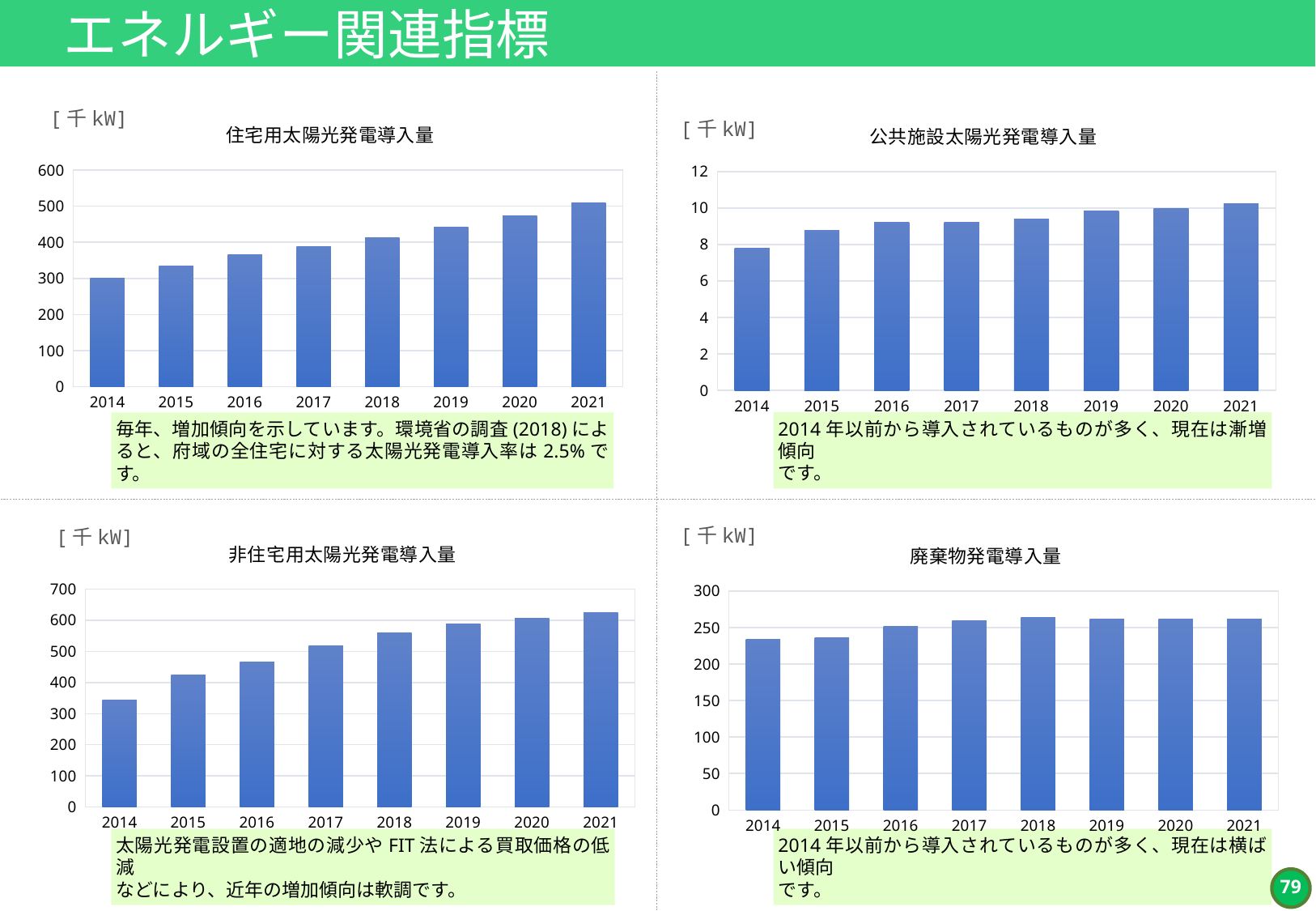
On the 住宅用太陽光発電導入量 chart, which year has the lowest value? 2014 On the 公共施設太陽光発電導入量 chart, is the value for 2015 greater or less than 8? greater On the 公共施設太陽光発電導入量 chart, which year has the lowest value? 2014 On the 住宅用太陽光発電導入量 chart, is the value for 2016 greater or less than 400? less On the 非住宅用太陽光発電導入量 chart, which year has the highest value? 2021 On the 廃棄物発電導入量 chart, which is larger, the value for 2014 or the value for 2021? 2021 On the 住宅用太陽光発電導入量 chart, which year has the highest value? 2021 On the 非住宅用太陽光発電導入量 chart, is the value for 2021 greater or less than 600? greater On the 住宅用太陽光発電導入量 chart, do the values rise or fall from 2014 to 2021? rise What kind of chart is the 住宅用太陽光発電導入量 chart? bar chart How many years are plotted on the 住宅用太陽光発電導入量 chart? 8